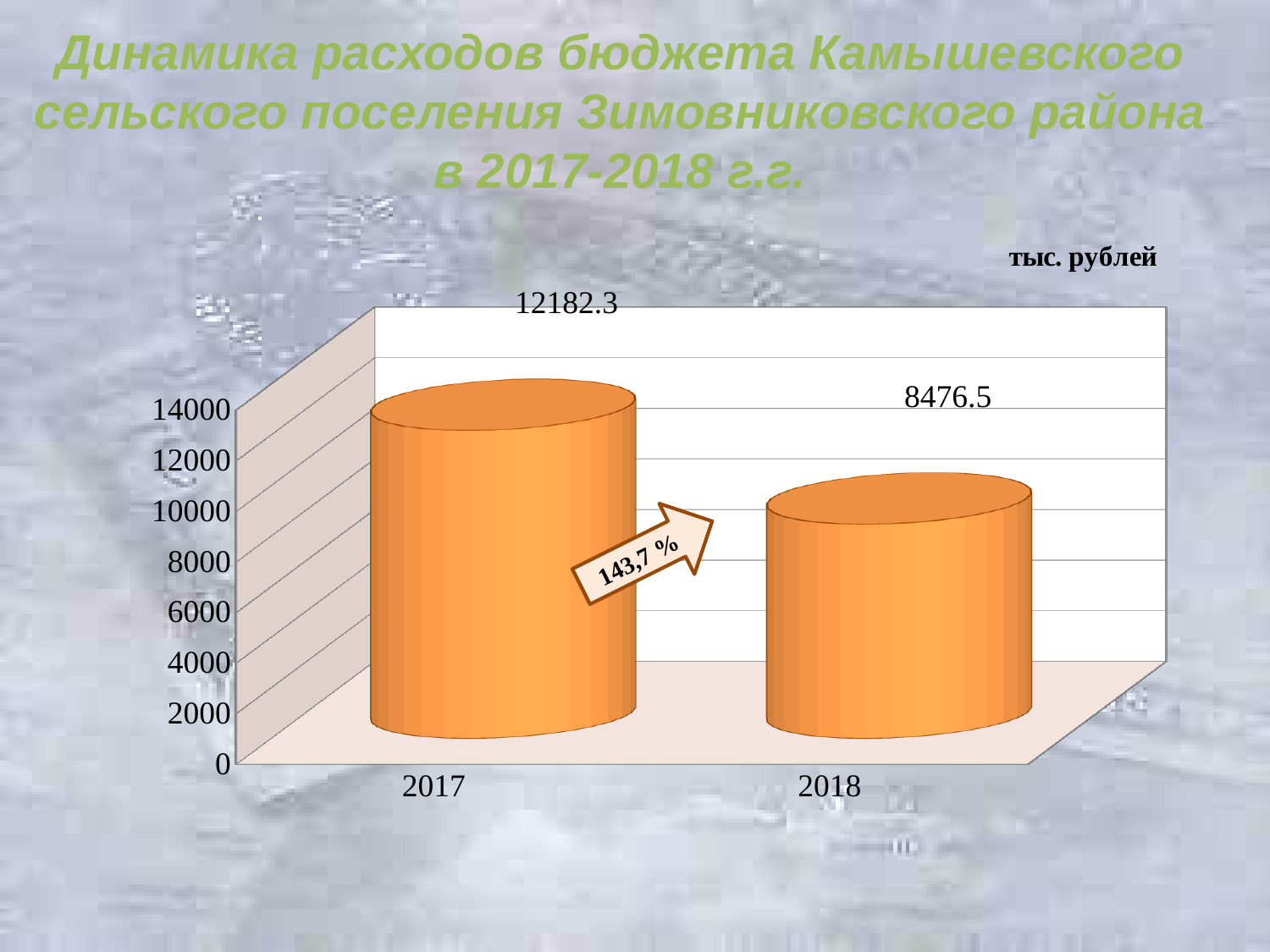
Do the values rise or fall from 2017 to 2018? fall What is the value shown for 2017? 12182.3 Which year has the lower value? 2018 Is the value for 2017 greater or less than 12000? greater How many years (categories) are plotted on the chart? 2 Which year has the higher value? 2017 Is the value for 2018 greater or less than 10000? less What unit of measurement is indicated above the chart? тыс. рублей Is the value for 2017 larger or smaller than the value for 2018? larger What is the value shown for 2018? 8476.5 What kind of chart is shown on the slide? bar chart What is the difference between the 2017 value and the 2018 value? 3705.8